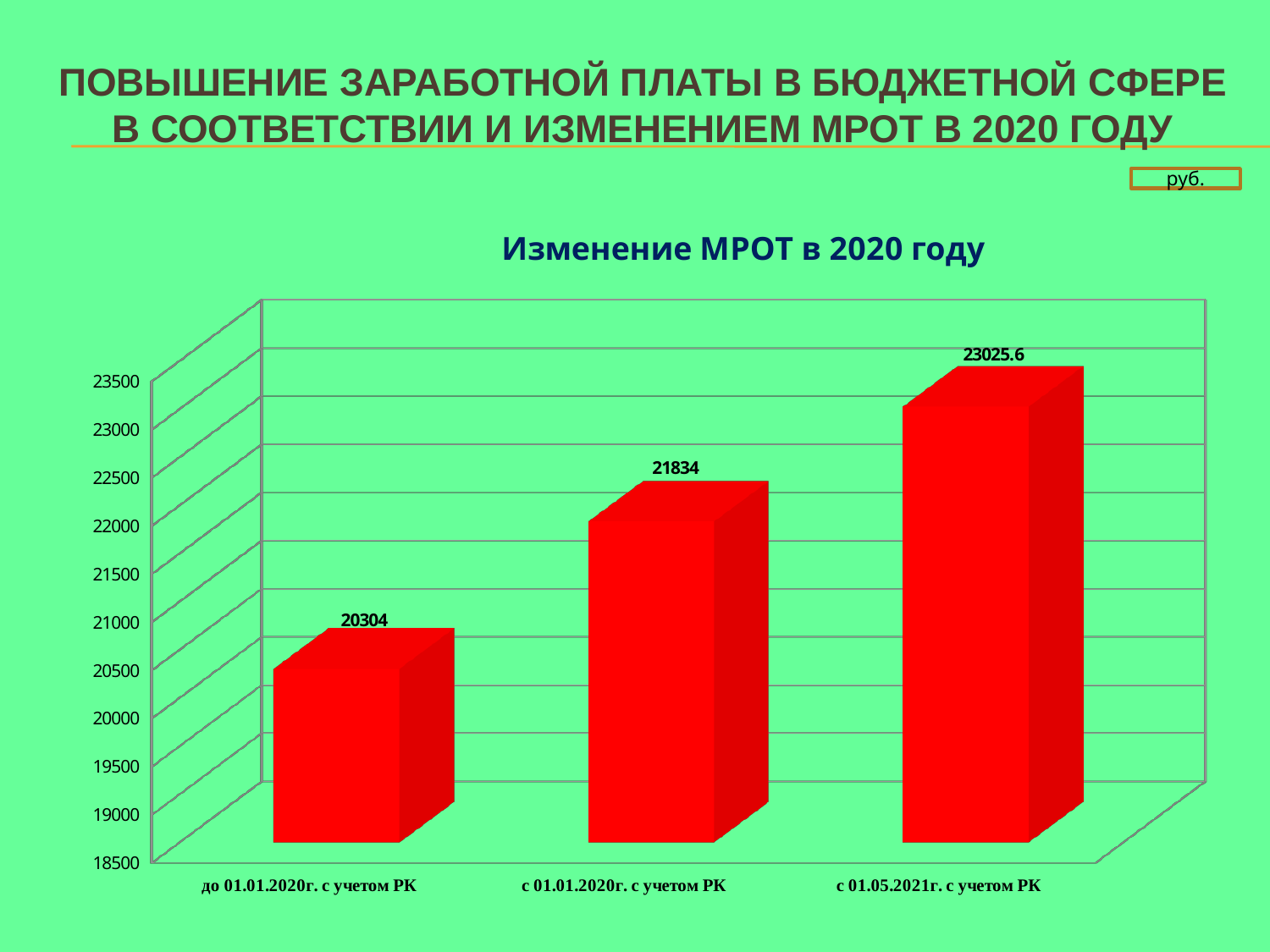
What is the difference between the values for "с 01.01.2020г. с учетом РК" and "до 01.01.2020г. с учетом РК"? 1530 What is the difference between the values for "с 01.05.2021г. с учетом РК" and "с 01.01.2020г. с учетом РК"? 1191.6 What is the value for "с 01.01.2020г. с учетом РК"? 21834 Which category has the lowest value? до 01.01.2020г. с учетом РК What is the value for "с 01.05.2021г. с учетом РК"? 23025.6 What kind of chart is shown on the slide? bar chart Do the values rise or fall from left to right along the x axis? rise What is the value for "до 01.01.2020г. с учетом РК"? 20304 Which category has the highest value? с 01.05.2021г. с учетом РК Which is larger: the value for "с 01.01.2020г. с учетом РК" or for "до 01.01.2020г. с учетом РК"? с 01.01.2020г. с учетом РК How many categories are shown in the chart? 3 Is the value for "с 01.01.2020г. с учетом РК" greater or less than 22000? less